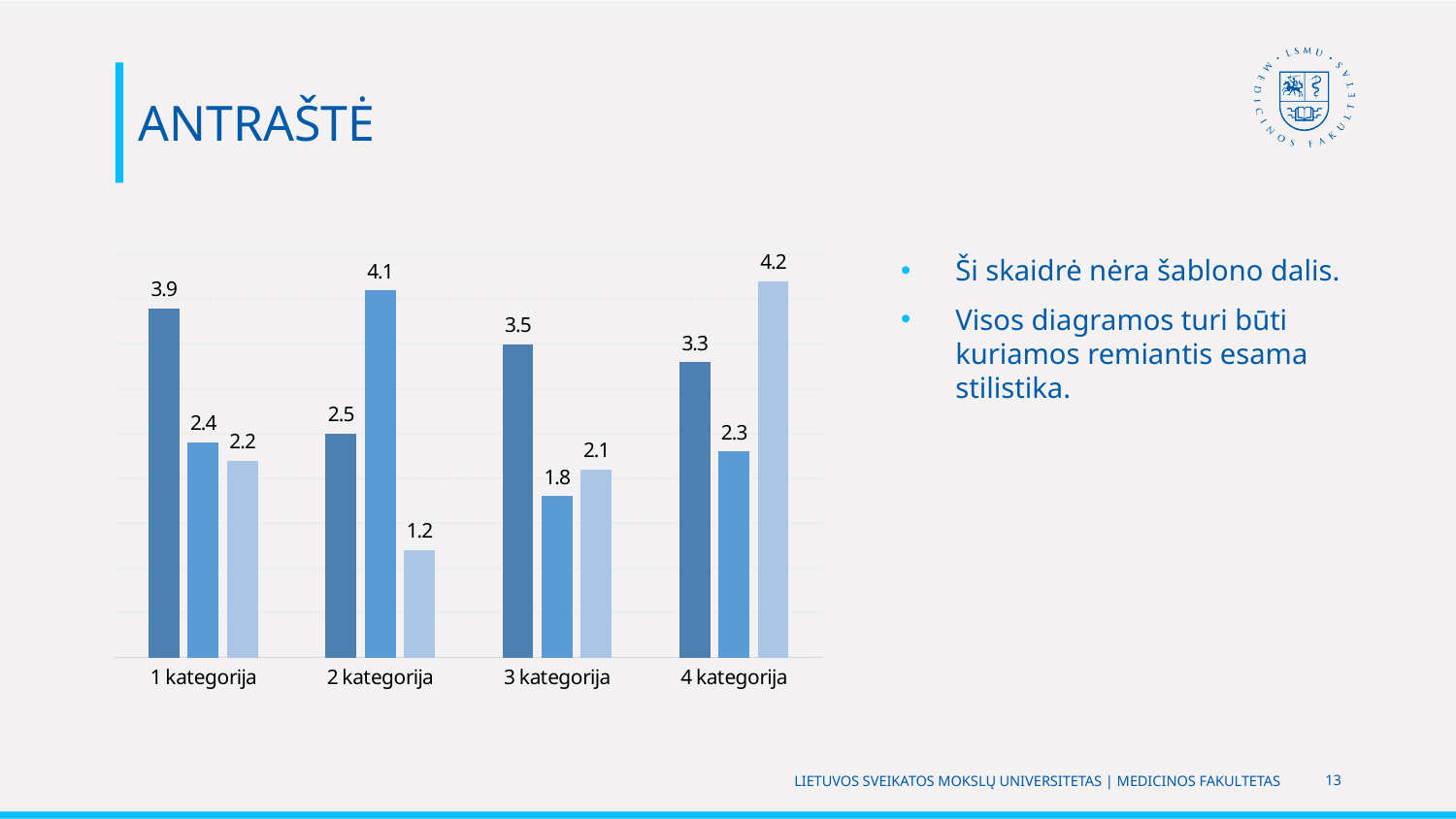
What is the value of the light blue bar for 4 kategorija? 4.2 How many categories are shown on the x axis? 4 Do the values of the dark blue bars rise or fall from 2 kategorija to 3 kategorija? rise Which category has the highest dark blue bar? 1 kategorija What is the difference between the dark blue bar and the medium blue bar for 1 kategorija? 1.5 What kind of chart is shown on the slide? bar chart What is the value of the medium blue bar for 3 kategorija? 1.8 What is the value of the light blue bar for 2 kategorija? 1.2 What is the difference between the medium blue bar and the light blue bar for 2 kategorija? 2.9 Which category has the lowest light blue bar? 2 kategorija What is the value of the dark blue bar for 1 kategorija? 3.9 Which is larger for 4 kategorija: the dark blue bar or the light blue bar? the light blue bar